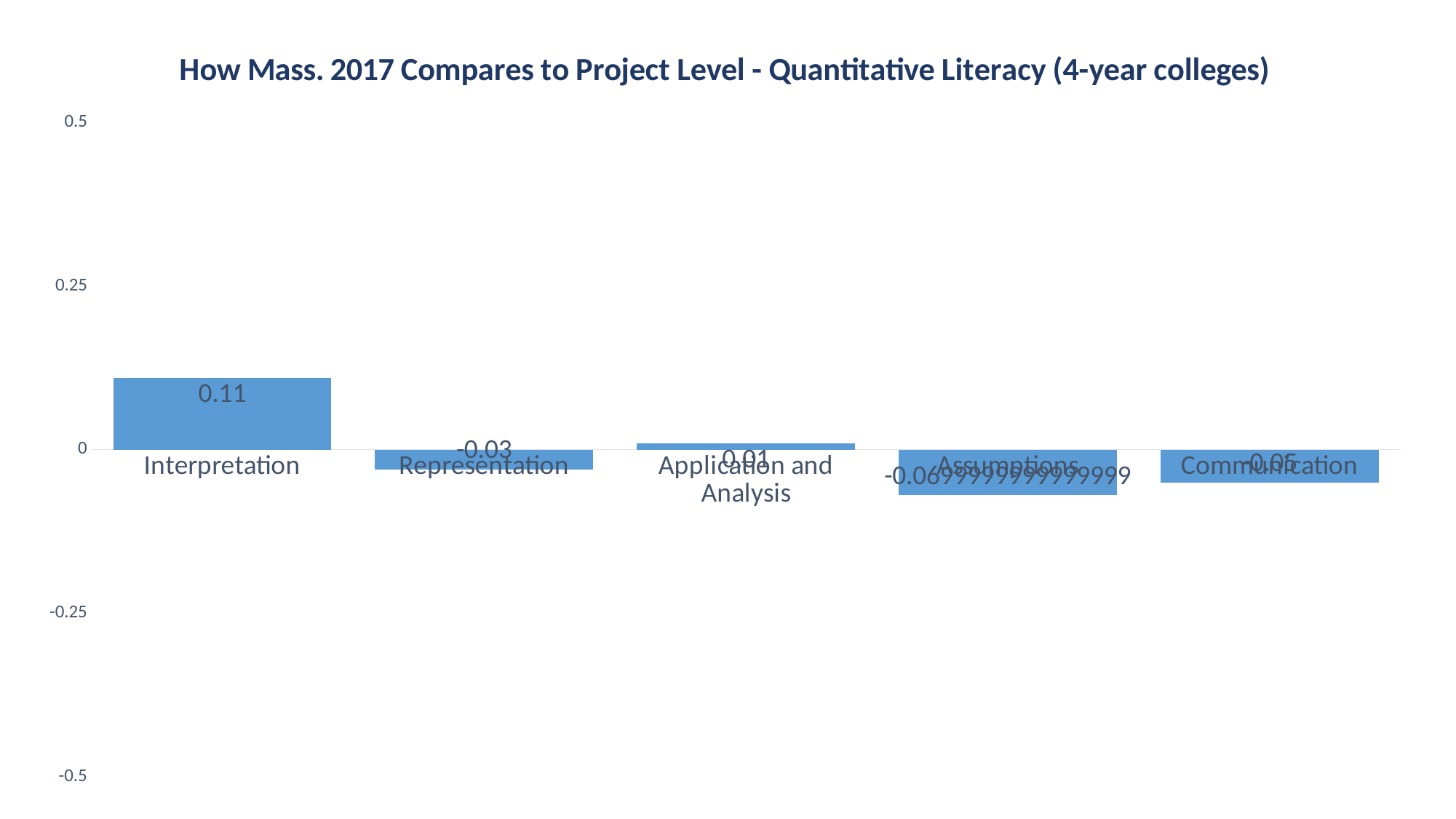
Which category has the lowest value? Assumptions Is the value for Interpretation greater or less than 0.25? less What kind of chart is shown on the slide? Bar chart What is the title of the chart? How Mass. 2017 Compares to Project Level - Quantitative Literacy (4-year colleges) What is the difference between the values for Interpretation and Representation? 0.14 Which category has the highest value? Interpretation What is the value for Interpretation? 0.11 What is the value for Representation? -0.03 Which is larger, the value for Interpretation or the value for Application and Analysis? Interpretation How many categories are shown on the x axis? 5 What is the value for Application and Analysis? 0.01 How many categories have a negative value? 3